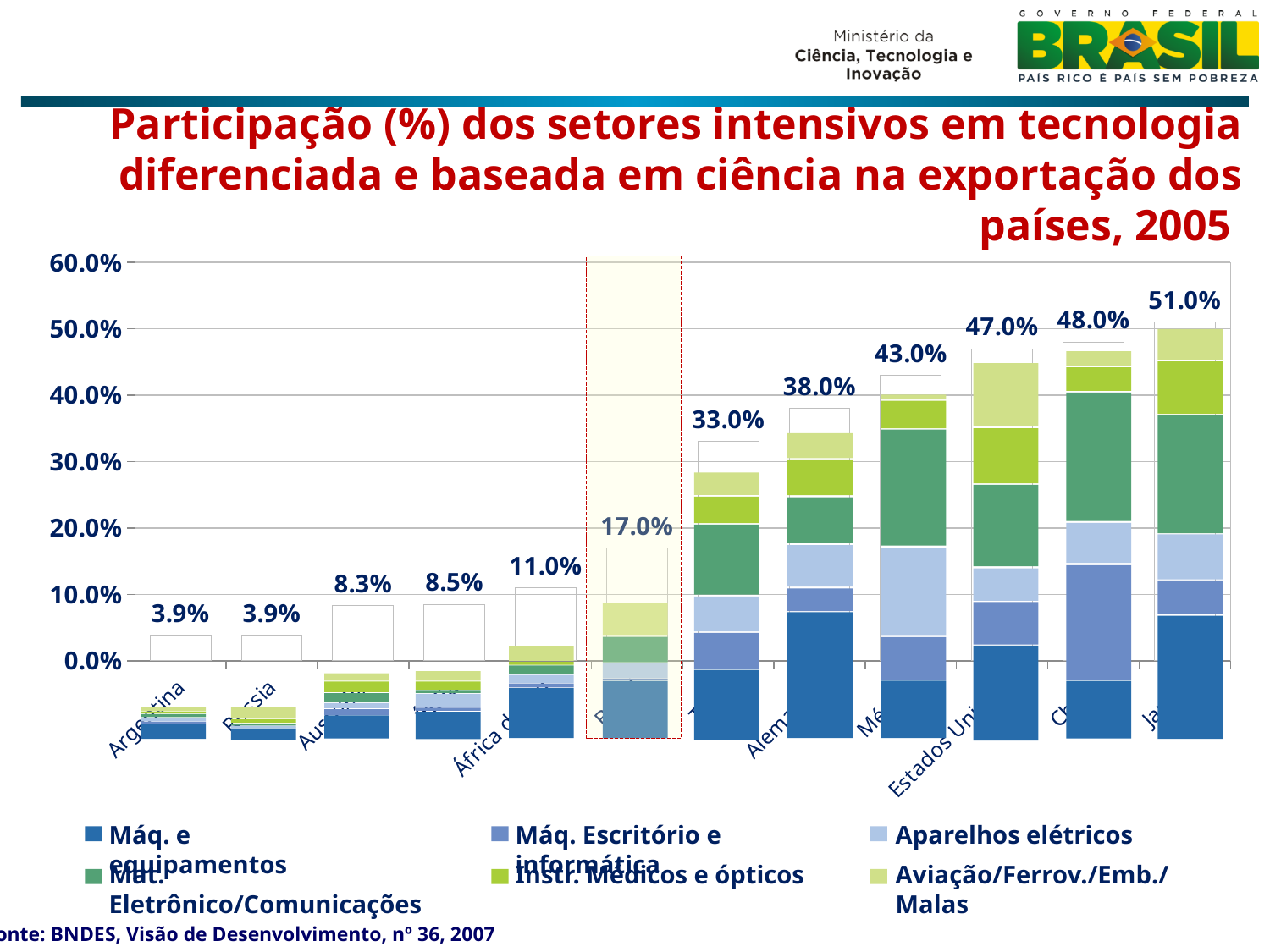
What is the total value shown for Argentina? 3.9% What is the total value shown for Brasil? 17.0% What kind of chart is shown on the slide? Stacked bar chart How many series does the legend list? 6 What is the lowest total value labelled on the chart? 3.9% What is the difference between the totals for Estados Unidos and Brasil? 30.0 percentage points What is the total value shown for Estados Unidos? 47.0% How many countries (bars) are shown on the chart? 12 What is the total value shown for África do Sul? 11.0% Which has a larger total, Brasil or Alemanha? Alemanha What is the highest total value labelled on the chart? 51.0% What is the total value shown for Alemanha? 38.0%